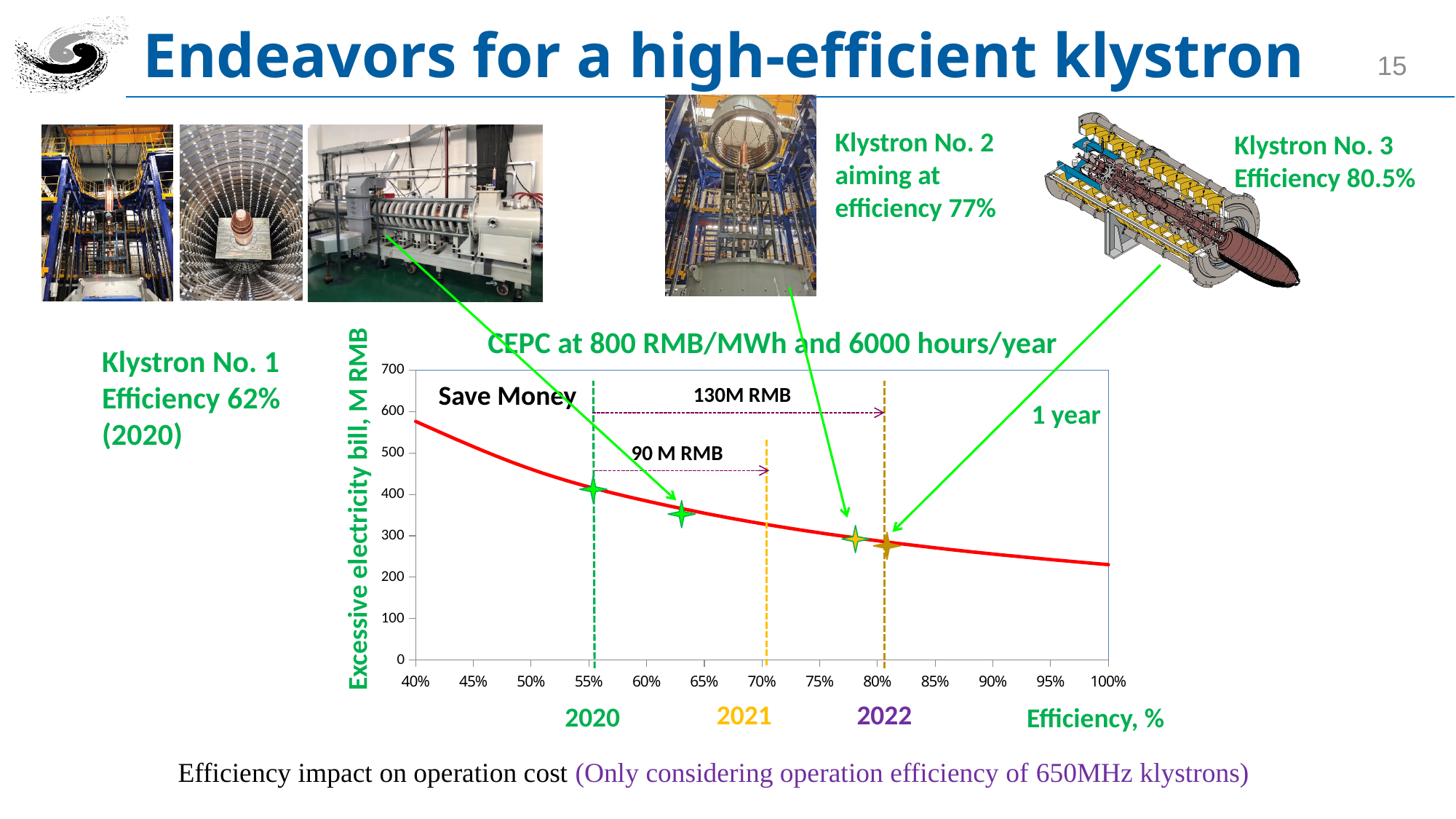
What is the label of the vertical axis of the chart? Excessive electricity bill, M RMB Is the excessive electricity bill at 45% efficiency greater or less than 400 M RMB? greater According to the chart annotation, how much money is saved per year by moving from the 2020 efficiency to the 2022 efficiency? 130M RMB Is the excessive electricity bill at 100% efficiency greater or less than 300 M RMB? less What kind of chart is shown on the slide? line chart Which of the two annotated savings on the chart is larger, the 2021 saving or the 2022 saving? 2022 saving (130M RMB) What is the title of the chart? CEPC at 800 RMB/MWh and 6000 hours/year Is the excessive electricity bill at 40% efficiency greater or less than 500 M RMB? greater Does the excessive electricity bill rise or fall as efficiency increases along the x axis? fall According to the chart annotation, how much money is saved per year by moving from the 2020 efficiency to the 2021 efficiency? 90 M RMB What is the difference between the two annotated savings, 130M RMB and 90 M RMB? 40 M RMB